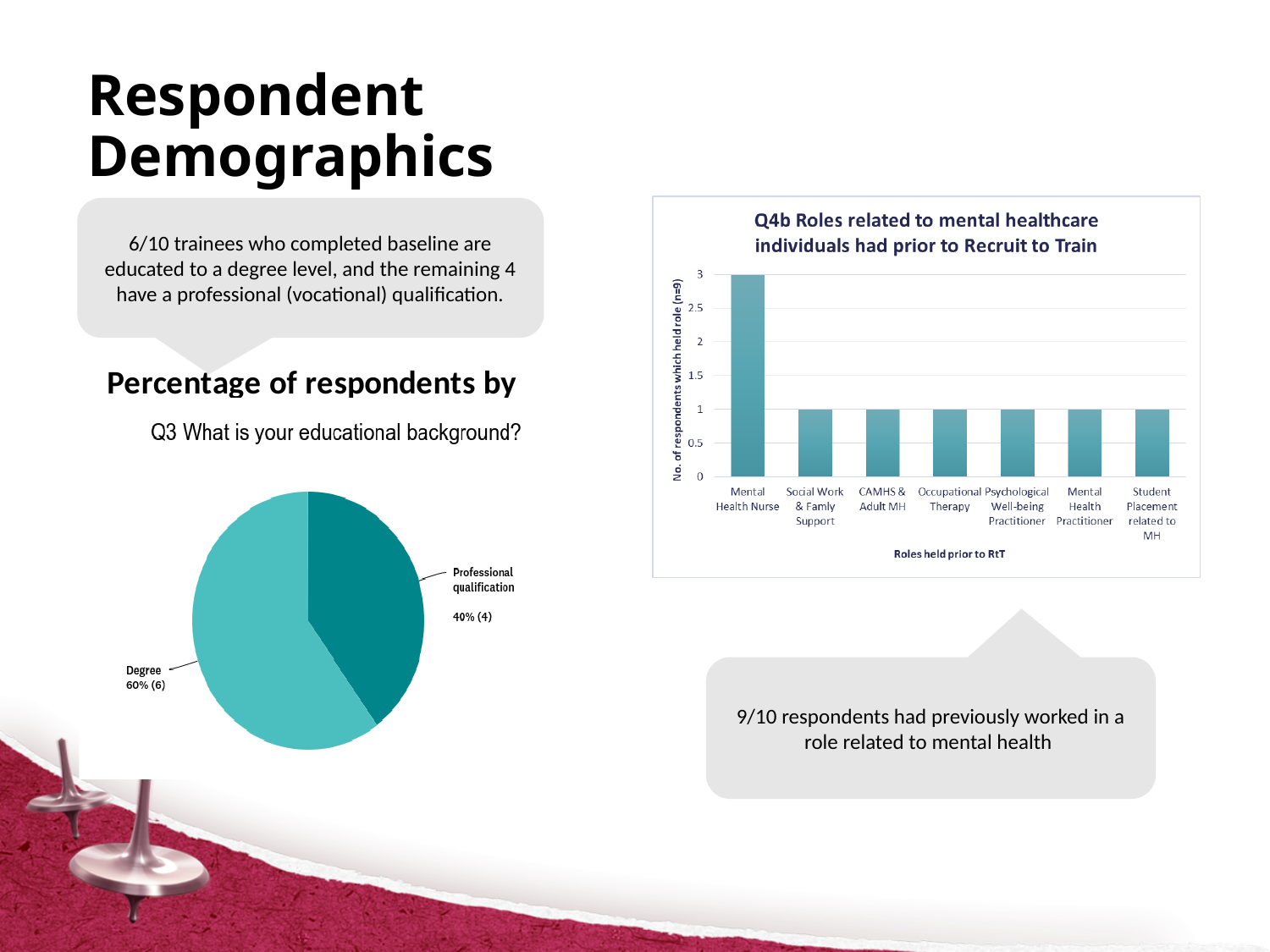
In the pie chart for Q3 educational background, how many respondents have a professional qualification? 4 In the Q4b chart, how many role categories are shown on the x axis? 7 In the pie chart for Q3 educational background, how many slices are there? 2 In the Q4b chart, what is the difference between the number of respondents who were Mental Health Nurses and those in Social Work & Family Support? 2 In the pie chart for Q3 educational background, which slice is larger, Degree or Professional qualification? Degree In the pie chart for Q3 educational background, what percentage of respondents have a degree? 60% In the Q4b chart, how many respondents held the role of Mental Health Nurse prior to Recruit to Train? 3 In the Q4b chart, how many respondents held the role of Occupational Therapy? 1 What kind of chart is the Q4b Roles related to mental healthcare chart? Bar chart In the Q4b chart, what is the label of the y axis? No. of respondents which held role (n=9) In the Q4b chart, which role has the highest number of respondents? Mental Health Nurse What kind of chart is used for Q3 What is your educational background? Pie chart